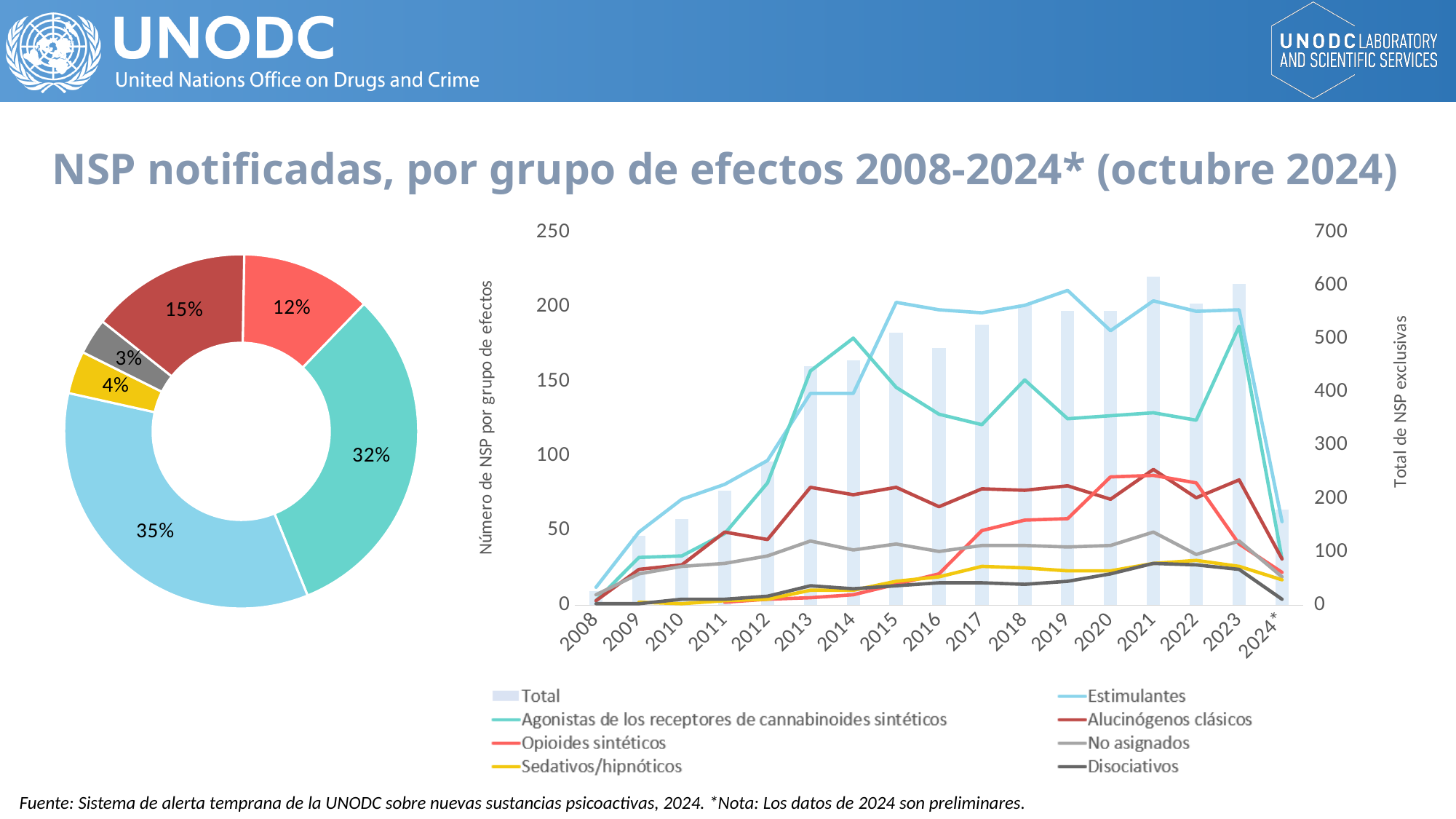
On the chart on the right, in 2020, which is larger: Estimulantes or Alucinógenos clásicos? Estimulantes What kind of chart is the chart on the right? Combined bar and line chart On the chart on the right, in which year is the Total bar tallest? 2021 How many series does the legend of the chart on the right list? 8 On the donut chart on the left, what is the smallest percentage shown? 3% On the donut chart on the left, what is the largest percentage shown? 35% On the chart on the right, does the Agonistas de los receptores de cannabinoides sintéticos line rise or fall from 2008 to 2014? rise On the donut chart on the left, what is the difference between the largest slice (35%) and the 12% slice? 23 percentage points On the chart on the right, is the Estimulantes value for 2013 greater or less than 150? less How many slices does the donut chart on the left have? 6 How many years are shown on the x axis of the chart on the right? 17 On the donut chart on the left, what percentage is shown on the teal slice? 32%